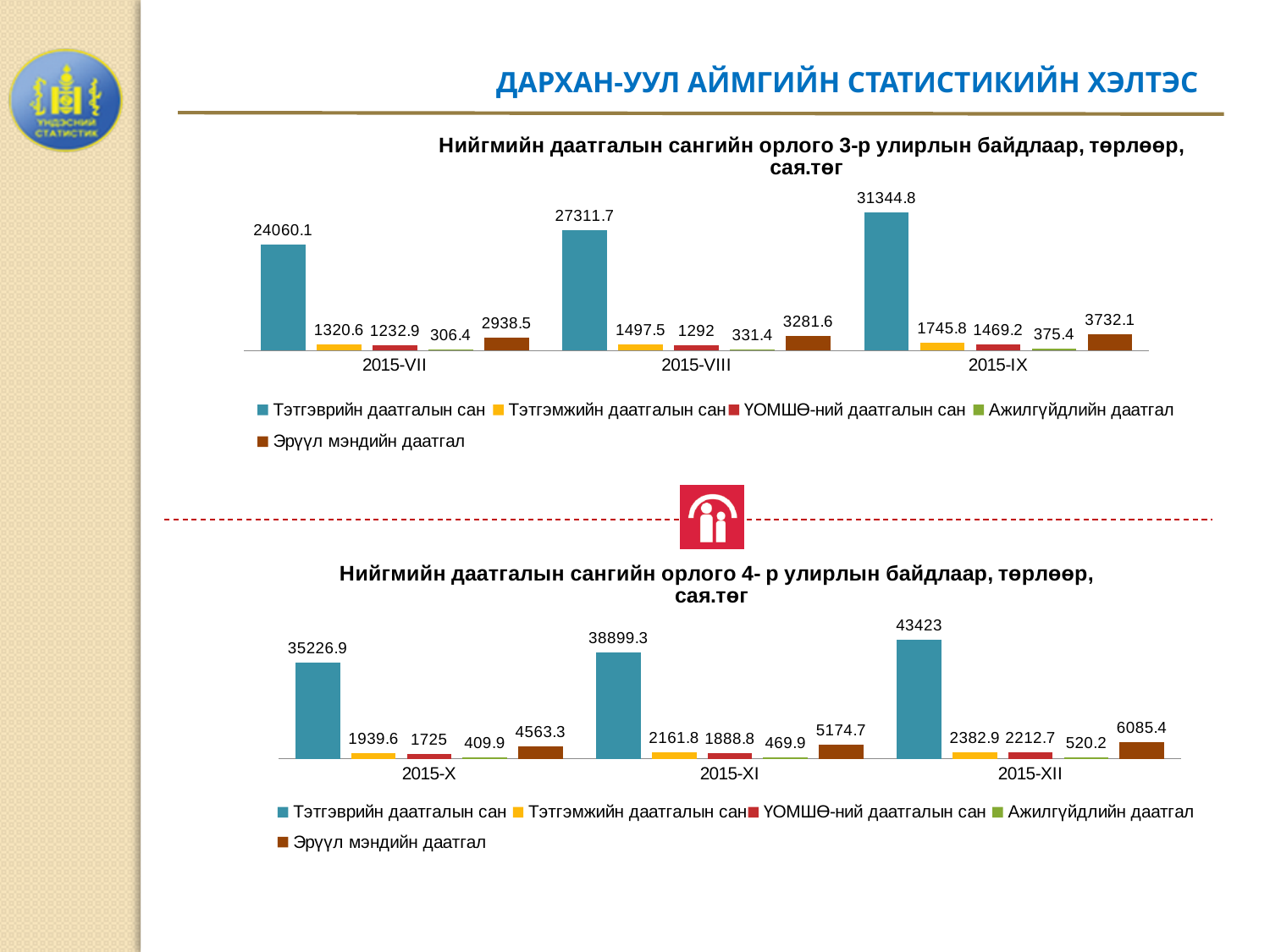
In the bottom chart (4-р улирлын), is the value of Тэтгэмжийн даатгалын сан larger in 2015-X or 2015-XII? 2015-XII In the bottom chart (4-р улирлын), what is the value of Тэтгэврийн даатгалын сан for 2015-XII? 43423 In the top chart (3-р улирлын), what is the value of Тэтгэврийн даатгалын сан for 2015-VII? 24060.1 In the top chart (3-р улирлын), what is the difference between the Тэтгэврийн даатгалын сан values for 2015-IX and 2015-VIII? 4033.1 What type of chart is the bottom chart (4-р улирлын)? bar chart In the top chart (3-р улирлын), what is the value of Эрүүл мэндийн даатгал for 2015-IX? 3732.1 In the bottom chart (4-р улирлын), what is the value of ҮОМШӨ-ний даатгалын сан for 2015-XI? 1888.8 In the bottom chart (4-р улирлын), does the value of Эрүүл мэндийн даатгал rise or fall from 2015-X to 2015-XII? rise In the top chart (3-р улирлын), which month has the highest value for Тэтгэврийн даатгалын сан? 2015-IX In the bottom chart (4-р улирлын), how many months are shown on the x axis? 3 In the top chart (3-р улирлын), how many series does the legend list? 5 In the top chart (3-р улирлын), which series has the lowest value in 2015-VIII? Ажилгүйдлийн даатгал